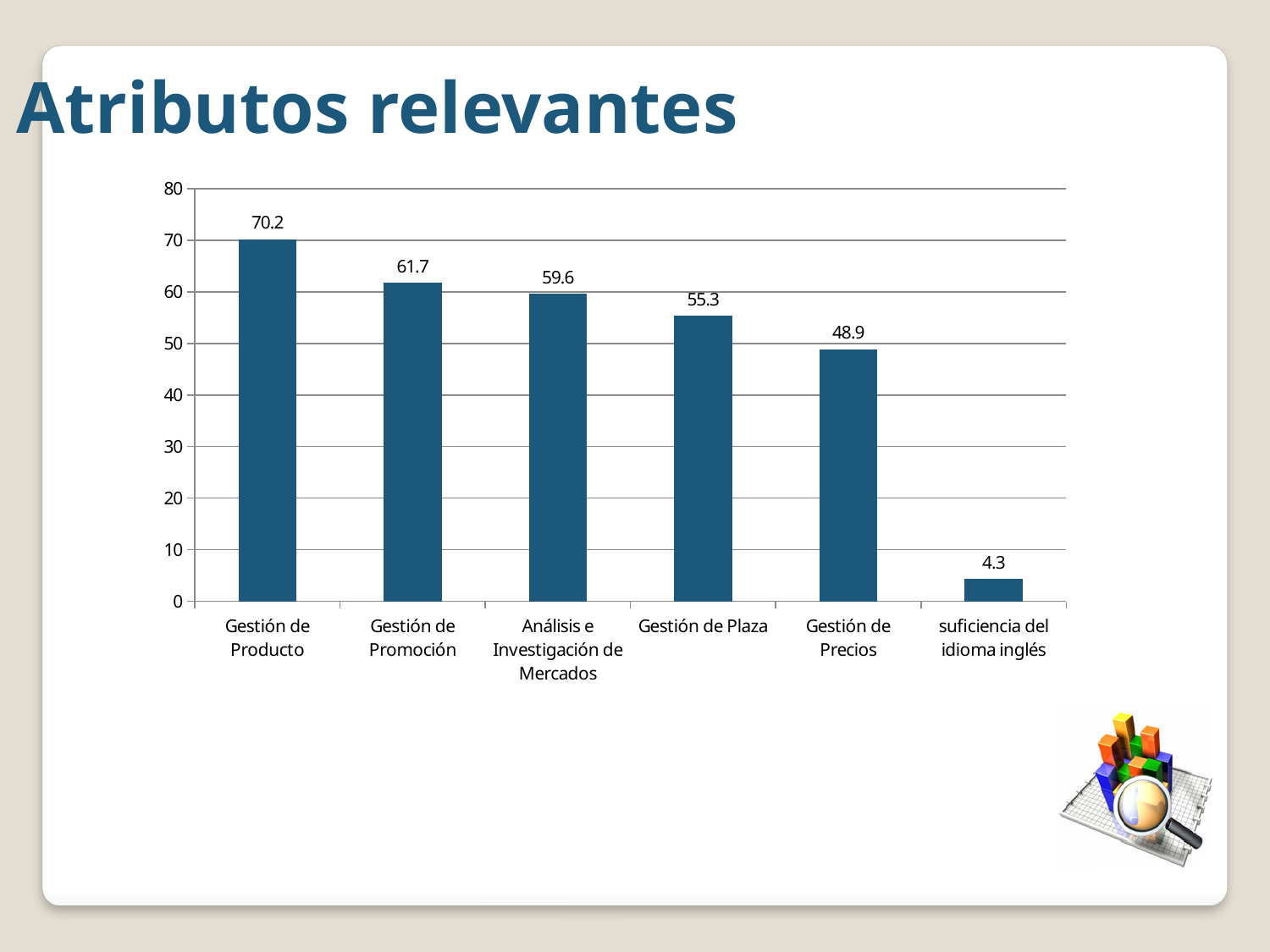
Do the values rise or fall from left to right along the x axis? fall Which is larger, the value for Análisis e Investigación de Mercados or the value for Gestión de Precios? Análisis e Investigación de Mercados Which category has the lowest value? suficiencia del idioma inglés Which category has the highest value? Gestión de Producto What is the value for suficiencia del idioma inglés? 4.3 Is the value for Gestión de Precios greater or less than 50? less How many categories are shown on the chart? 6 What is the value for Gestión de Producto? 70.2 What is the value for Gestión de Plaza? 55.3 What is the difference between the values for Gestión de Plaza and Gestión de Precios? 6.4 What is the difference between the values for Gestión de Producto and Gestión de Promoción? 8.5 What kind of chart is shown on the slide? bar chart